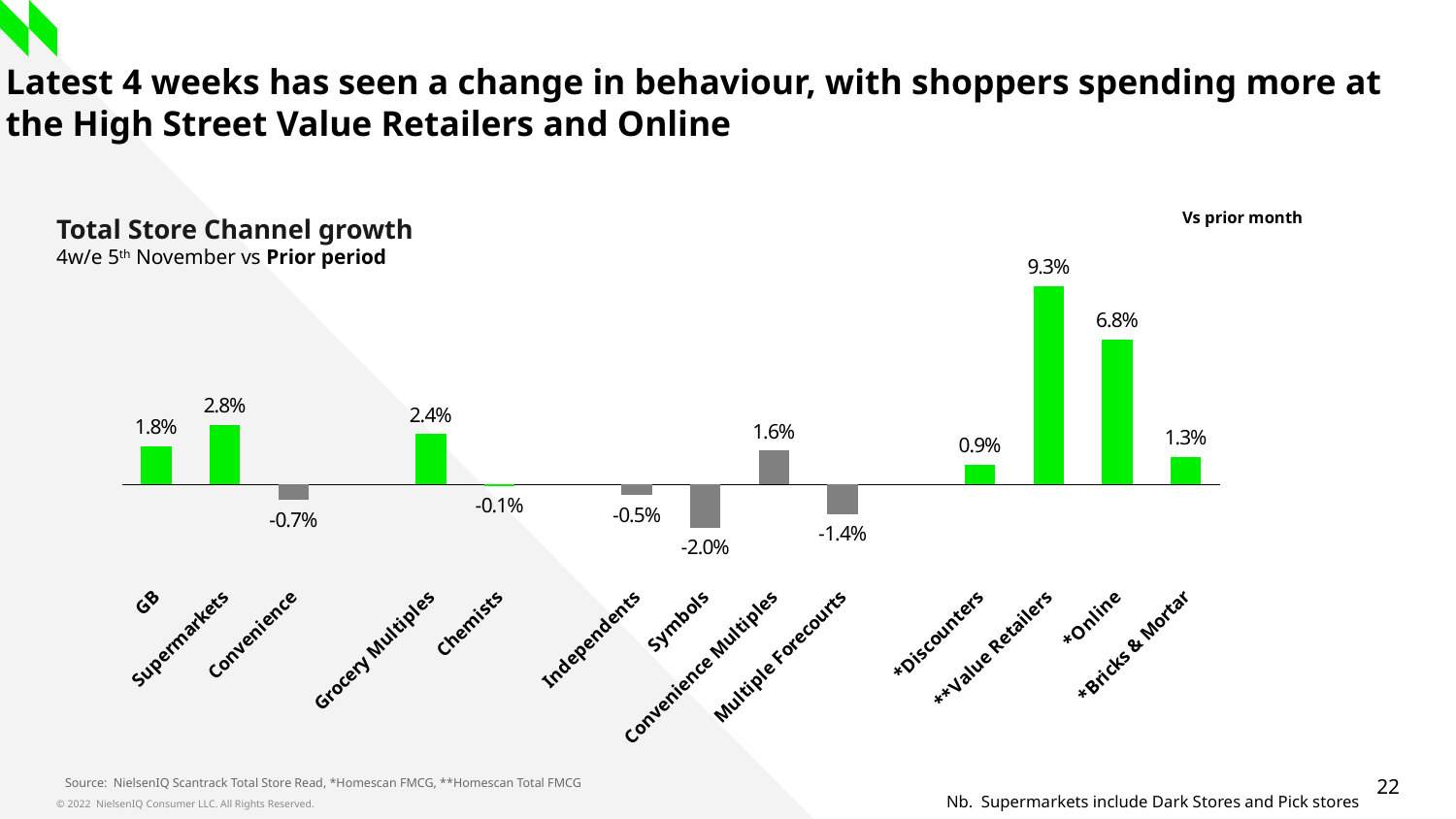
What type of chart is used to show Total Store Channel growth? Bar chart What is the difference in growth between Value Retailers and Online? 2.5 percentage points What colour are the bars with negative growth values? Grey What is the growth value for Convenience? -0.7% How many channels are shown in the Total Store Channel growth chart? 13 What is the growth value for Online? 6.8% What is the growth value for Symbols? -2.0% What is the difference in growth between Supermarkets and GB? 1.0 percentage point Which channel has the highest growth in the chart? Value Retailers What is the growth value for Value Retailers in the Total Store Channel growth chart? 9.3% Which channel has the lowest growth in the chart? Symbols Which has higher growth, Supermarkets or Grocery Multiples? Supermarkets